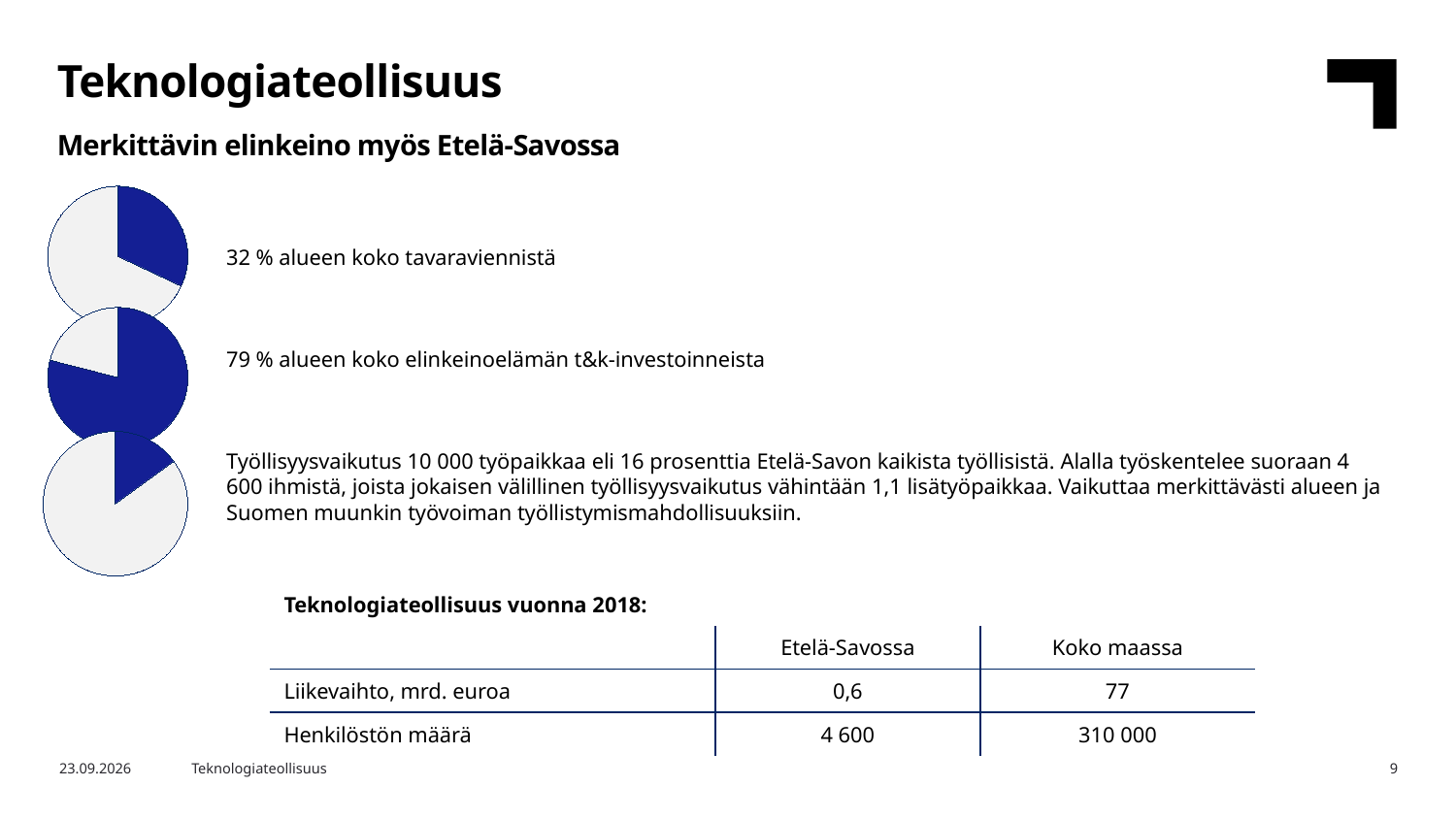
What colour is used for the highlighted slice in each pie chart? dark blue How many slices does each pie chart on the slide have? 2 Is the highlighted slice in the middle pie chart greater or less than 50% of the pie? greater Which of the three pie charts has the largest highlighted (dark blue) slice: the top, middle or bottom one? middle Is the highlighted slice in the top pie chart greater or less than 50% of the pie? less According to the text next to the bottom pie chart, what percentage of all employed people in Etelä-Savo does the highlighted slice represent? 16 prosenttia According to the text next to the middle pie chart, what share of the region's business R&D investments does the highlighted slice represent? 79 % How many pie charts are shown on the slide? 3 What kind of chart is the top chart on the left of the slide? pie chart Is the highlighted slice in the top pie chart larger or smaller than the highlighted slice in the middle pie chart? smaller According to the text next to the top pie chart, what share of the region's total goods exports does the highlighted slice represent? 32 % Which of the three pie charts has the smallest highlighted (dark blue) slice: the top, middle or bottom one? bottom